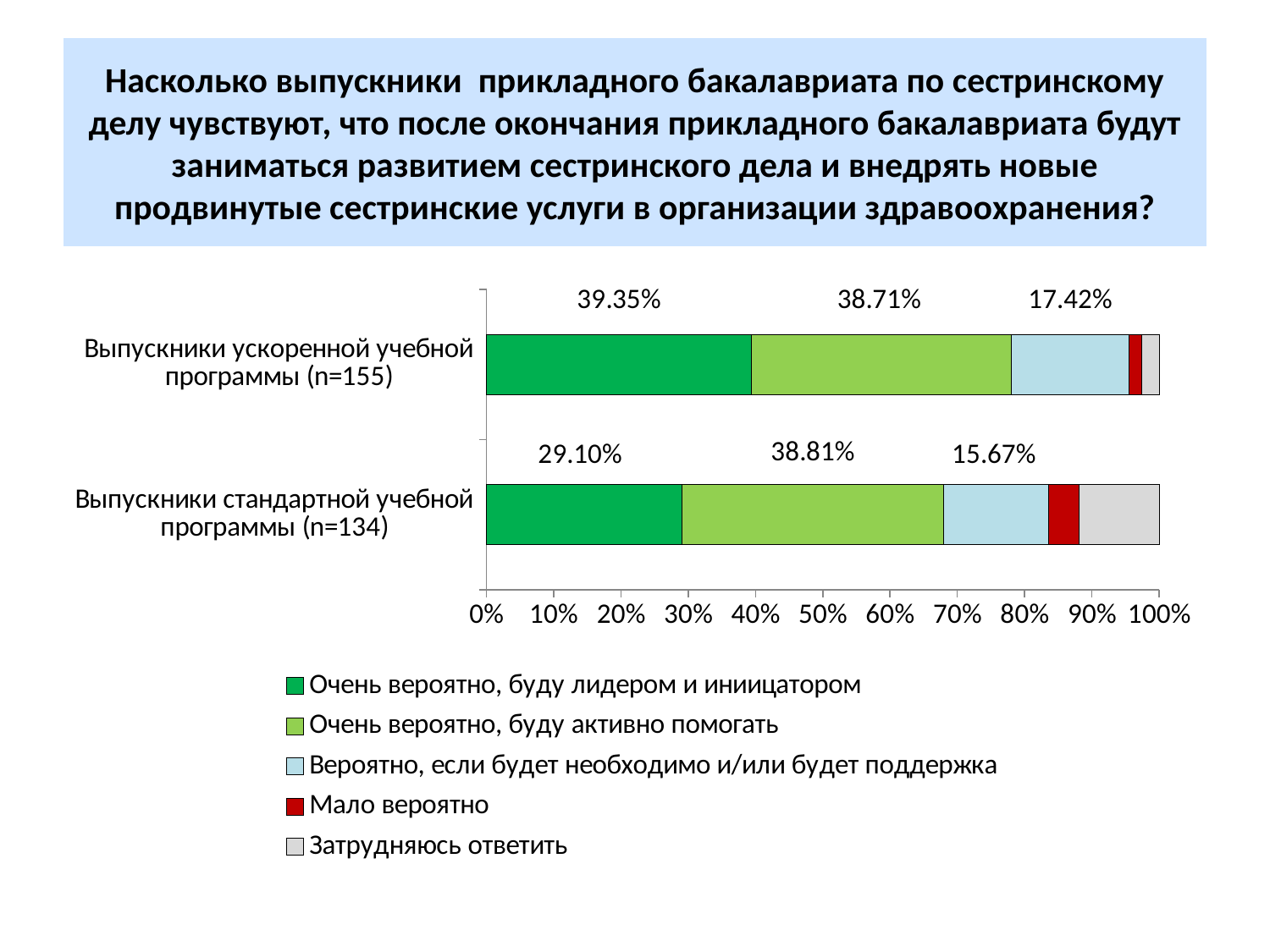
What is the value for "Очень вероятно, буду активно помогать" among graduates of the standard programme (n=134)? 38.81% What percentage of graduates of the accelerated programme (n=155) answered "Очень вероятно, буду лидером и инициатором"? 39.35% What percentage of graduates of the standard programme (n=134) answered "Очень вероятно, буду лидером и инициатором"? 29.10% What type of chart is shown on the slide? Stacked bar chart What is the difference in percentage points between the accelerated and standard programme graduates for "Вероятно, если будет необходимо и/или будет поддержка"? 1.75 percentage points What is the difference in percentage points between the accelerated and standard programme graduates for "Очень вероятно, буду лидером и инициатором"? 10.25 percentage points Is the share of "Затрудняюсь ответить" among graduates of the standard programme (n=134) greater or less than 20%? less What is the value for "Вероятно, если будет необходимо и/или будет поддержка" among graduates of the accelerated programme (n=155)? 17.42% How many groups of graduates are shown on the chart? 2 How many response categories does the legend list? 5 Which response category has the largest share among graduates of the standard programme (n=134)? Очень вероятно, буду активно помогать Which group has the larger share answering "Очень вероятно, буду лидером и инициатором": the accelerated programme or the standard programme? Выпускники ускоренной учебной программы (n=155)